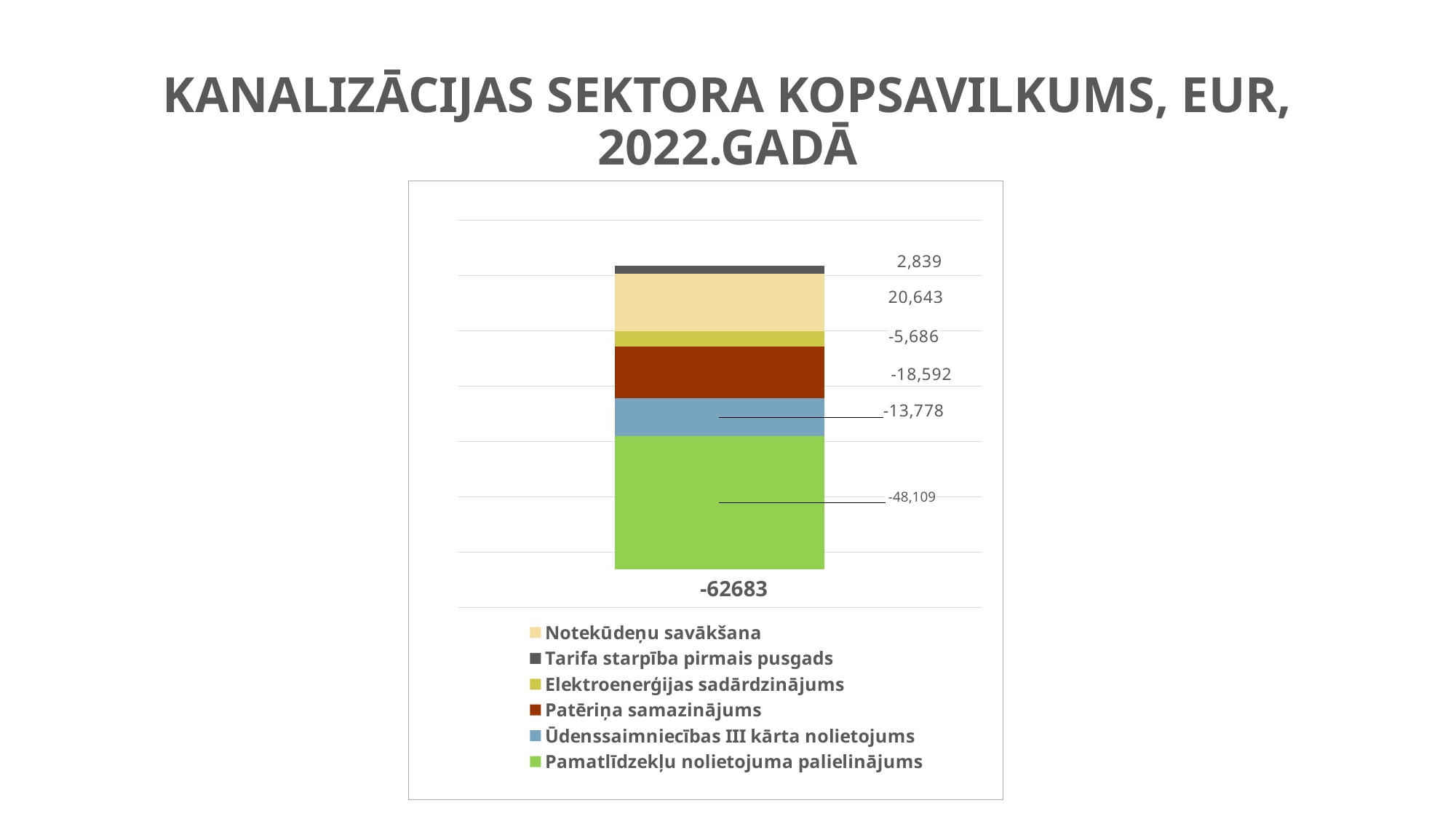
Which is larger in magnitude: Patēriņa samazinājums or Ūdenssaimniecības III kārta nolietojums? Patēriņa samazinājums How many series does the legend list? 6 What is the total of the stacked bar, as labelled on the x axis? -62683 What is the value for Pamatlīdzekļu nolietojuma palielinājums? -48,109 What is the value for Ūdenssaimniecības III kārta nolietojums? -13,778 What is the value for Notekūdeņu savākšana? 20,643 What is the value for Patēriņa samazinājums? -18,592 What is the value for Elektroenerģijas sadārdzinājums? -5,686 Which series has the lowest value? Pamatlīdzekļu nolietojuma palielinājums Which series has the highest value? Notekūdeņu savākšana What is the difference between the values for Notekūdeņu savākšana and Tarifa starpība pirmais pusgads? 17,804 What is the value for Tarifa starpība pirmais pusgads? 2,839